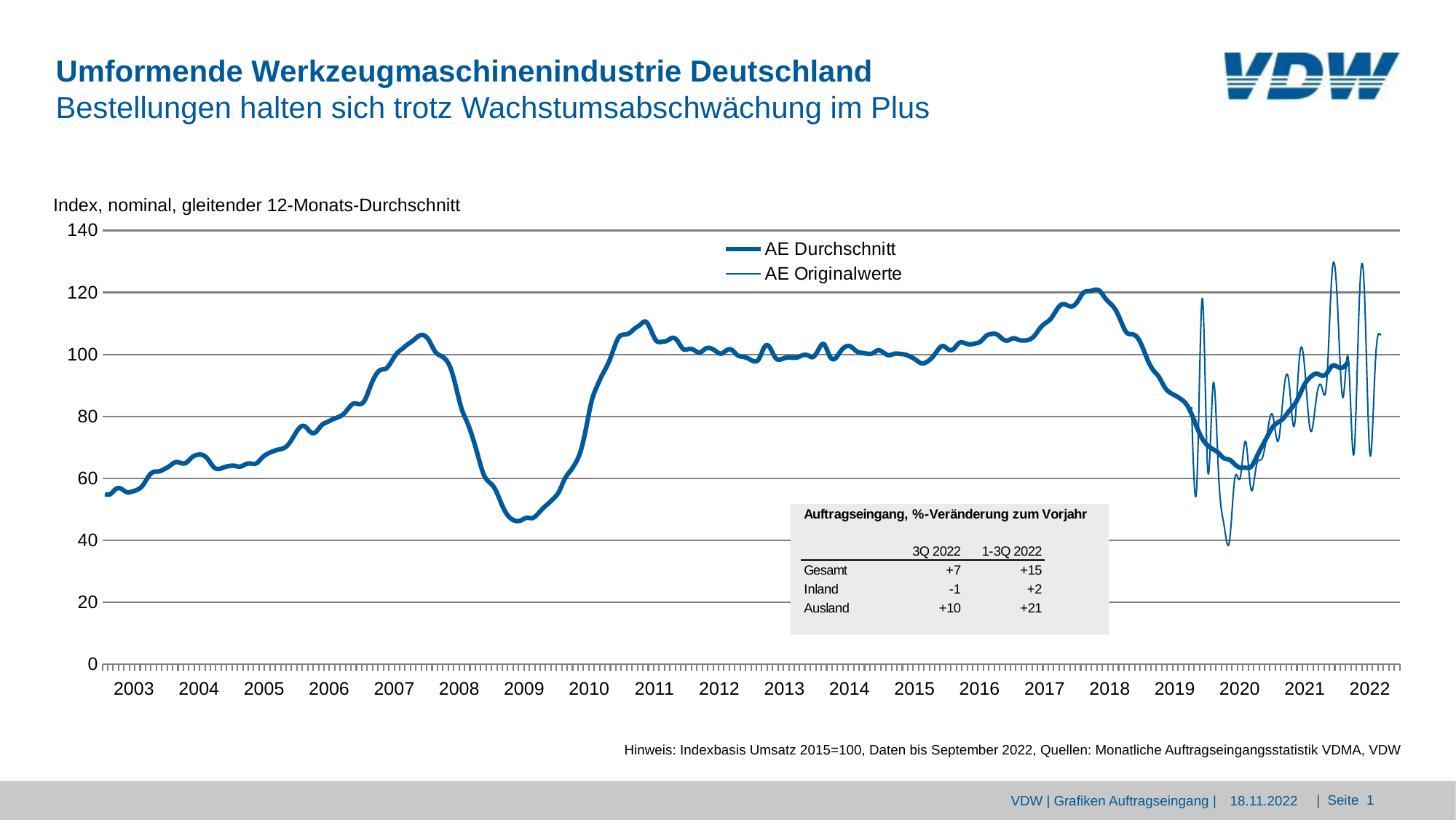
Is the value of the AE Durchschnitt line at the start of 2003 greater or less than 60? less Which is higher for the AE Durchschnitt line: the peak around 2007 or the peak around 2018? the peak around 2018 What kind of chart is shown on the slide? line chart Is the lowest value of the AE Durchschnitt line in 2009 greater or less than 60? less Is the peak of the AE Durchschnitt line in 2007 greater or less than 100? greater How many years are labelled on the x axis? 20 What is the label printed above the chart describing the index? Index, nominal, gleitender 12-Monats-Durchschnitt How many series does the legend list? 2 In which year does the AE Durchschnitt line reach its lowest level? 2009 What are the two series named in the legend? AE Durchschnitt and AE Originalwerte Does the AE Durchschnitt line rise or fall between 2018 and 2020? fall In which year does the AE Durchschnitt line reach its highest level? 2018